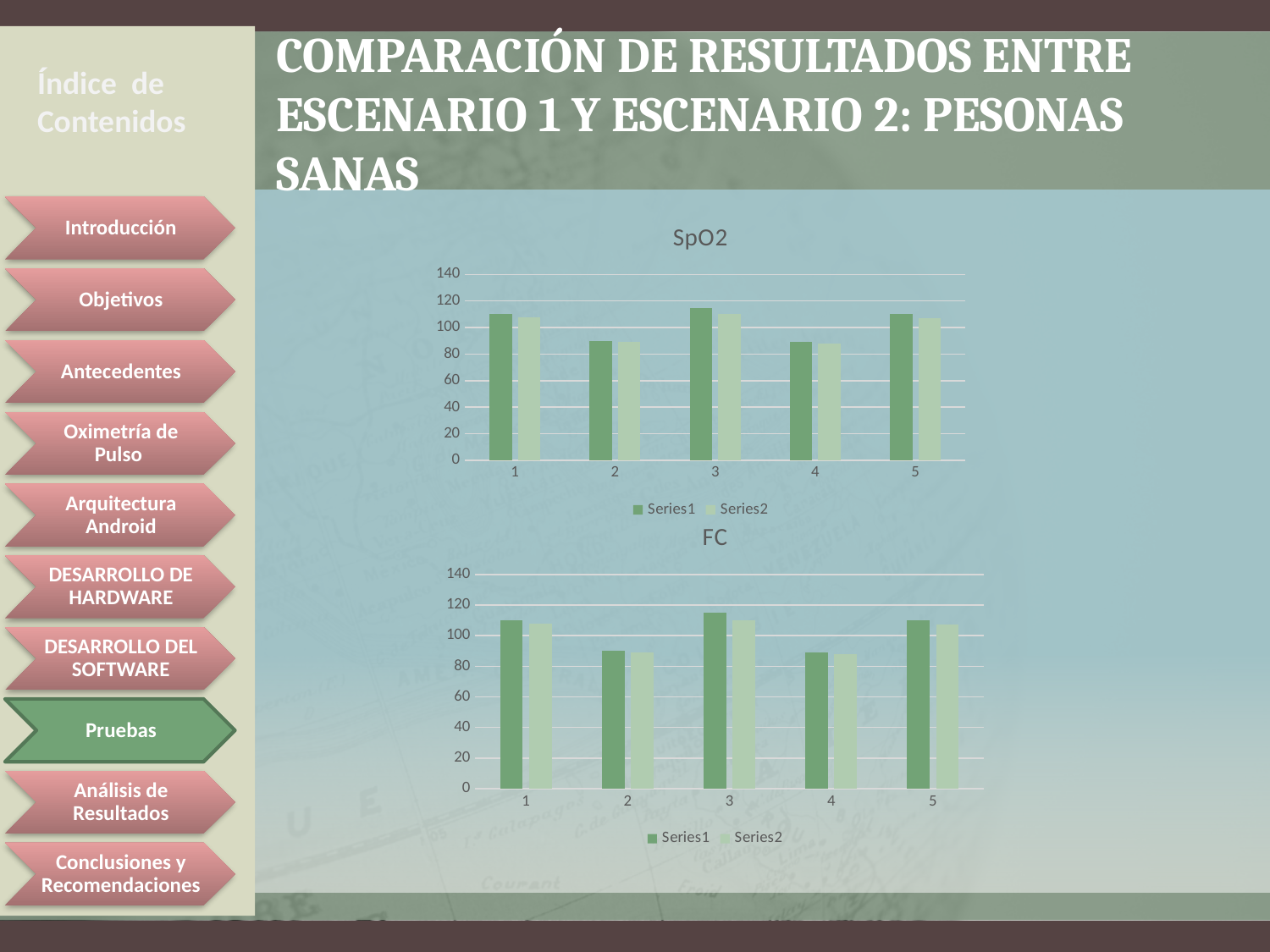
How many series does the legend of the FC chart list? 2 In the FC chart, is the Series2 value for category 4 greater or less than 100? less What kind of chart is the SpO2 chart? bar chart In the FC chart, which category has the highest Series1 value? 3 What are the names of the two series in the legend of the FC chart? Series1 and Series2 How many categories are shown on the x axis of the SpO2 chart? 5 How many categories are shown on the x axis of the FC chart? 5 What kind of chart is the FC chart? bar chart In the SpO2 chart, is the Series1 value for category 3 greater or less than 100? greater In the SpO2 chart, is the Series1 value for category 2 greater or less than 100? less How many series does the legend of the SpO2 chart list? 2 In the SpO2 chart, which is larger for Series1: category 1 or category 2? category 1